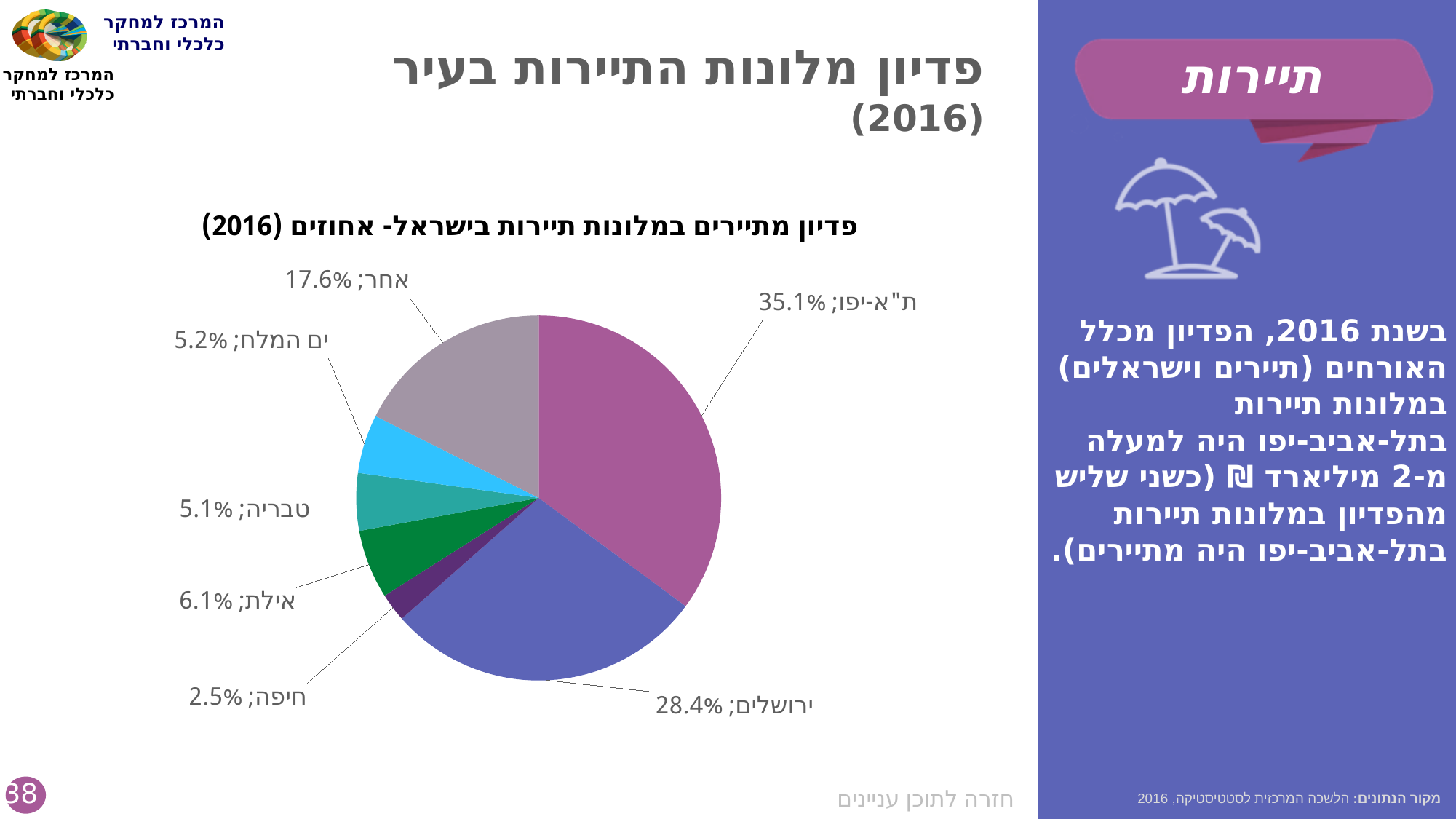
What is the combined share of ים המלח and טבריה? 10.3% What is the difference between the shares of ת"א-יפו and ירושלים? 6.7% What type of chart is shown on the slide? Pie chart Which is larger, the share for אילת or the share for טבריה? אילת Which category has the largest slice of the pie? ת"א-יפו How many slices does the pie chart have? 7 What share of the pie does ת"א-יפו (Tel Aviv-Yafo) hold? 35.1% What is the title of the chart? פדיון מתיירים במלונות תיירות בישראל- אחוזים (2016) What percentage is shown for חיפה (Haifa)? 2.5% What is the value for אילת (Eilat)? 6.1% What is the value shown for ירושלים (Jerusalem)? 28.4% Which category has the smallest slice of the pie? חיפה